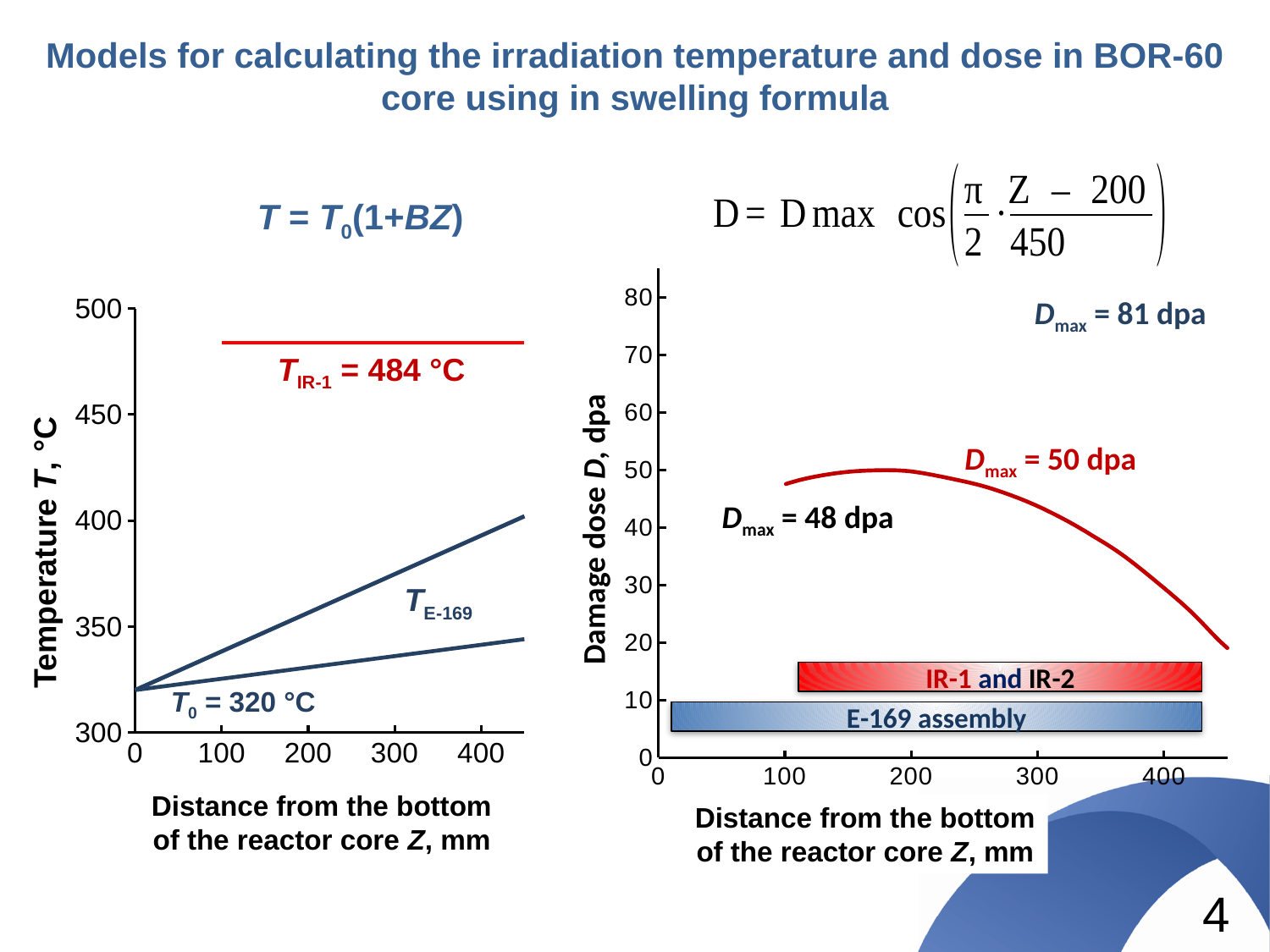
On the left chart (Temperature T vs distance Z), what is the value of T_0? 320 °C On the right chart (Damage dose D vs distance Z), is the damage dose at Z = 400 mm greater or less than 40? less On the right chart (Damage dose D vs distance Z), does the red curve rise or fall between Z = 200 mm and Z = 450 mm? falls What is the y-axis label of the right chart? Damage dose D, dpa On the left chart (Temperature T vs distance Z), what is the difference between T_IR-1 and T_0? 164 °C On the left chart (Temperature T vs distance Z), is the value of T_IR-1 greater or less than 450? greater On the right chart (Damage dose D vs distance Z), what is the smallest D_max value labelled? 48 dpa On the left chart (Temperature T vs distance Z), does the T_E-169 line rise or fall as Z increases? rises What kind of chart is the left chart (Temperature T vs distance Z)? line chart On the right chart (Damage dose D vs distance Z), what is the largest D_max value labelled? 81 dpa On the left chart (Temperature T vs distance Z), which is larger, T_IR-1 or T_0? T_IR-1 On the left chart (Temperature T vs distance Z), what is the value of T_IR-1? 484 °C